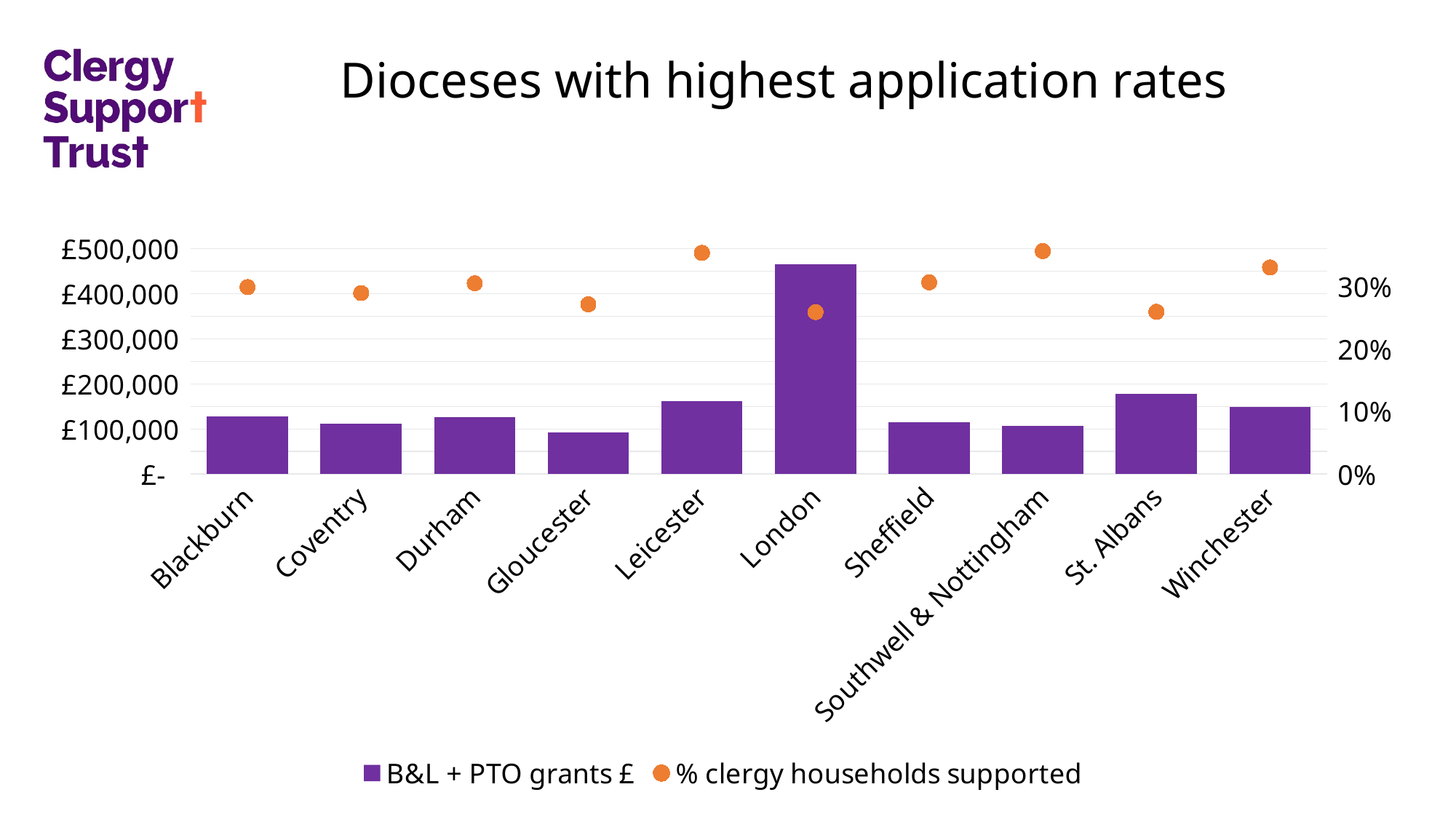
Which diocese has the lowest B&L + PTO grants £ bar? Gloucester Is the % clergy households supported value for London greater or less than 30%? less What kind of chart is shown on the slide? A bar chart with a dot (marker) series on a secondary axis Is the B&L + PTO grants £ value for St. Albans greater or less than £100,000? greater Is the % clergy households supported value for Leicester greater or less than 30%? greater Which diocese has the highest B&L + PTO grants £ bar? London How many series does the chart legend list? 2 Which has the larger B&L + PTO grants £ bar, St. Albans or Gloucester? St. Albans What is the title of the chart? Dioceses with highest application rates How many dioceses are shown on the x axis of the chart? 10